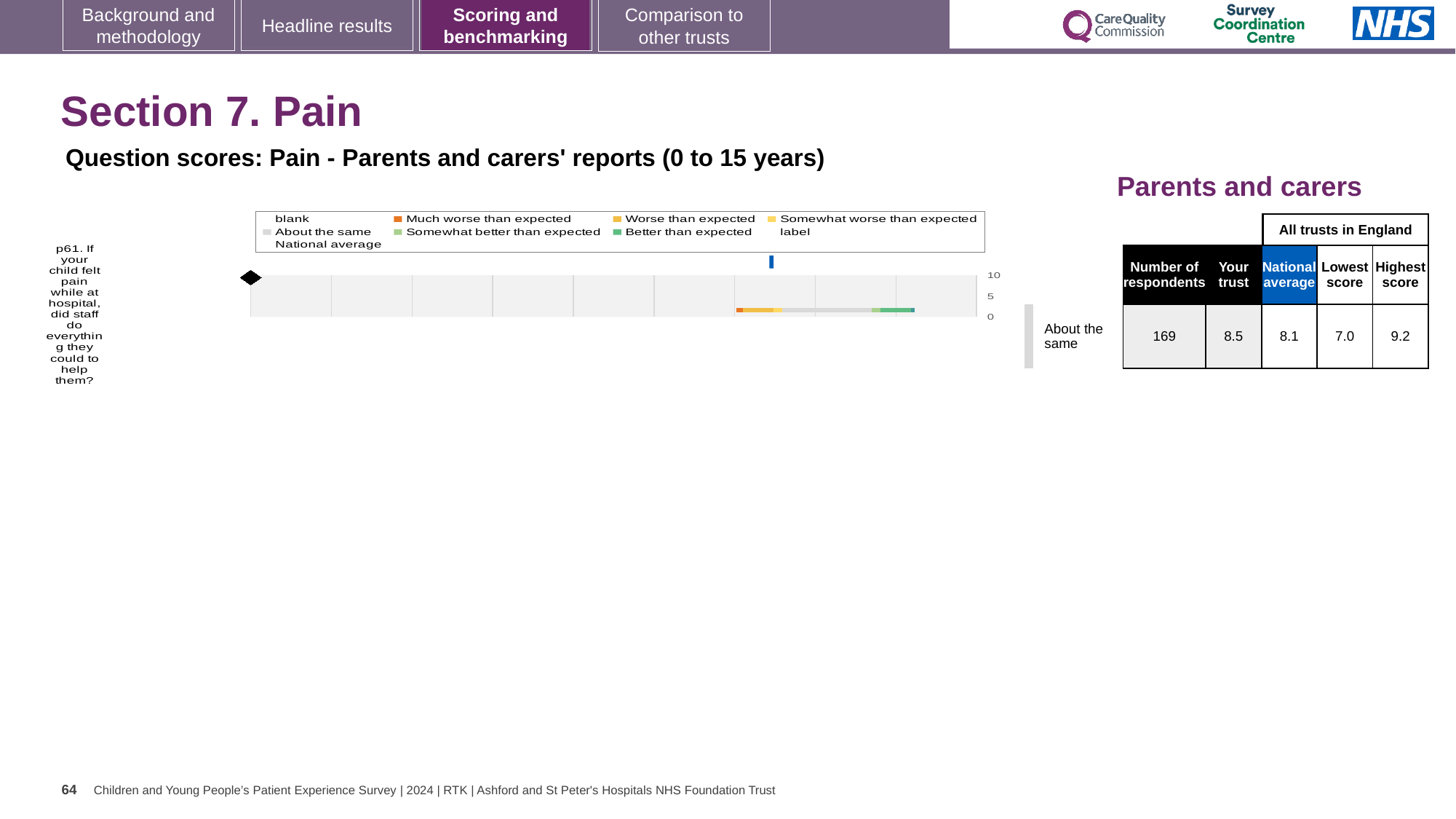
What is the highest score among all trusts in England for question p61? 9.2 What is the lowest score among all trusts in England for question p61? 7.0 What colour does the legend use for 'Much worse than expected'? orange What is the highest value shown on the chart's axis? 10 Is the national average marker for question p61 greater or less than 5? greater How many respondents answered question p61? 169 What kind of chart is shown on the slide? bar chart What is the difference between the 'Your trust' score and the national average for question p61? 0.4 How many survey questions (categories) are plotted on the chart? 1 What is the 'Your trust' score for question p61 shown on the slide? 8.5 Which is larger for question p61, the 'Your trust' score or the national average? Your trust What is the national average score for question p61 shown on the slide? 8.1